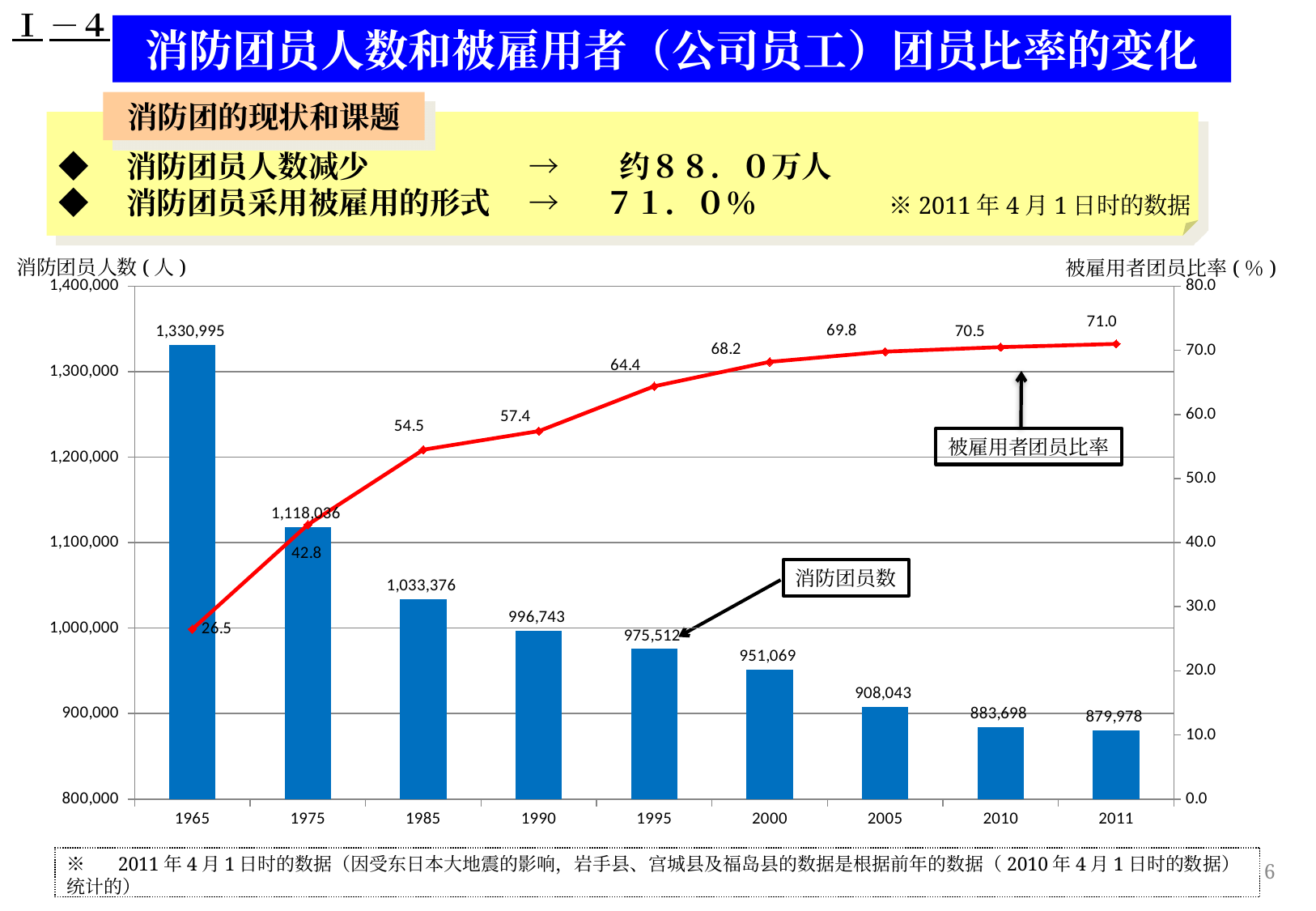
What is the employed-member ratio (被雇用者团员比率) shown for 2011? 71.0 Which year has more fire corps members, 1995 or 2000? 1995 Which year has the highest number of fire corps members? 1965 What is the employed-member ratio (被雇用者团员比率) shown for 1990? 57.4 How many years are shown on the x axis of the chart? 9 By how many percentage points did the employed-member ratio increase from 1965 to 2011? 44.5 Is the employed-member ratio for 1985 greater or less than 50.0? greater Does the number of fire corps members rise or fall from 1965 to 2011? Fall Which year has the lowest number of fire corps members? 2011 What is the difference between the number of fire corps members in 2010 and in 2011? 3,720 What kind of chart is shown on the slide? A bar chart combined with a line chart What is the number of fire corps members (消防团员人数) shown for 1965? 1,330,995